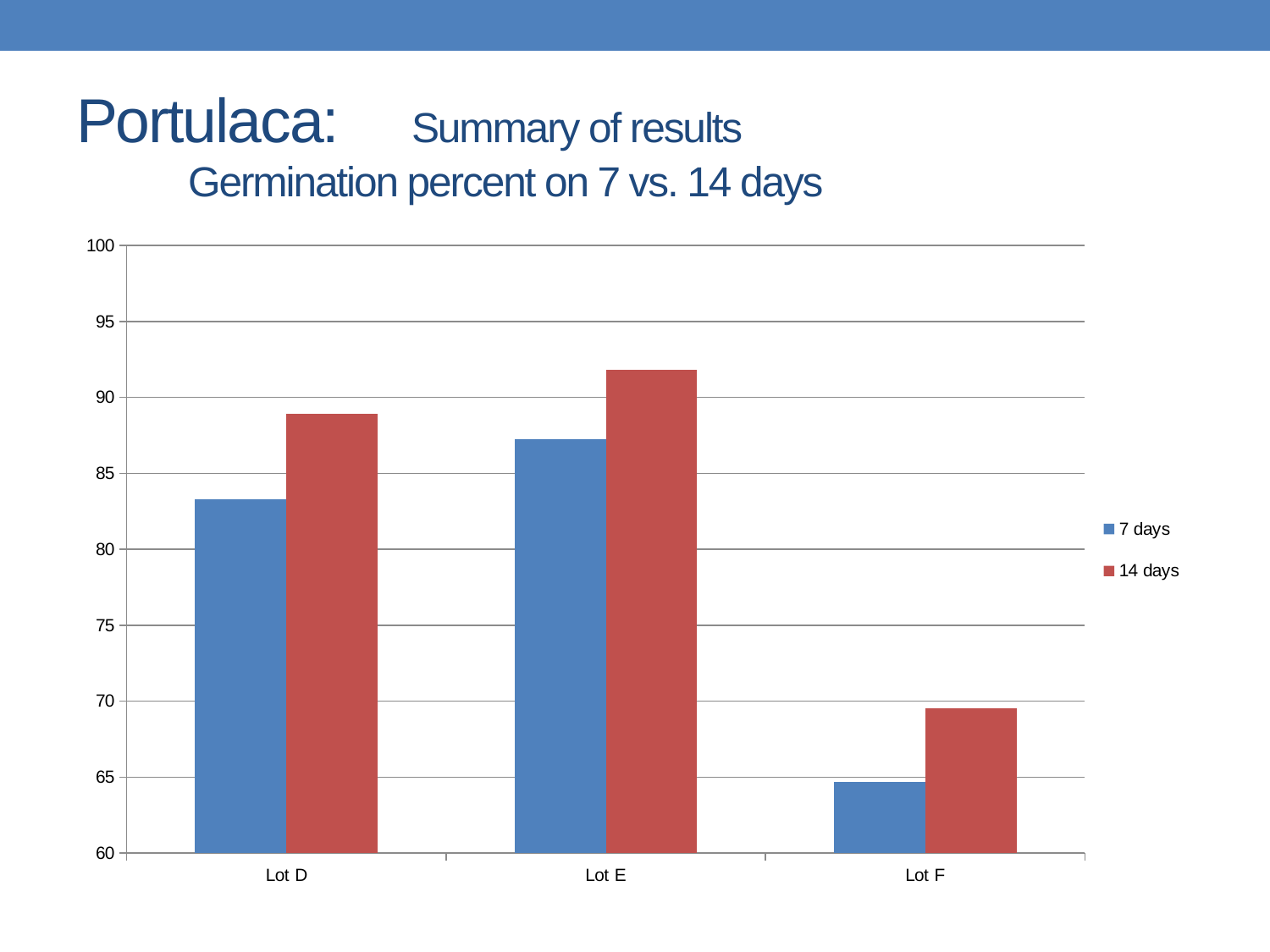
What colour are the 14 days bars? red How many series does the legend list? 2 Which lot has the lowest 7 days germination percent? Lot F Which lot has the lowest 14 days germination percent? Lot F Which lot has the highest 14 days germination percent? Lot E For Lot E, which is larger: the 7 days value or the 14 days value? 14 days How many lots are shown on the x axis? 3 What kind of chart is shown on the slide? bar chart Which is larger: the 7 days value for Lot E or the 14 days value for Lot D? 14 days value for Lot D Is the 14 days value for Lot E greater or less than 90? greater Is the 7 days value for Lot D greater or less than 85? less